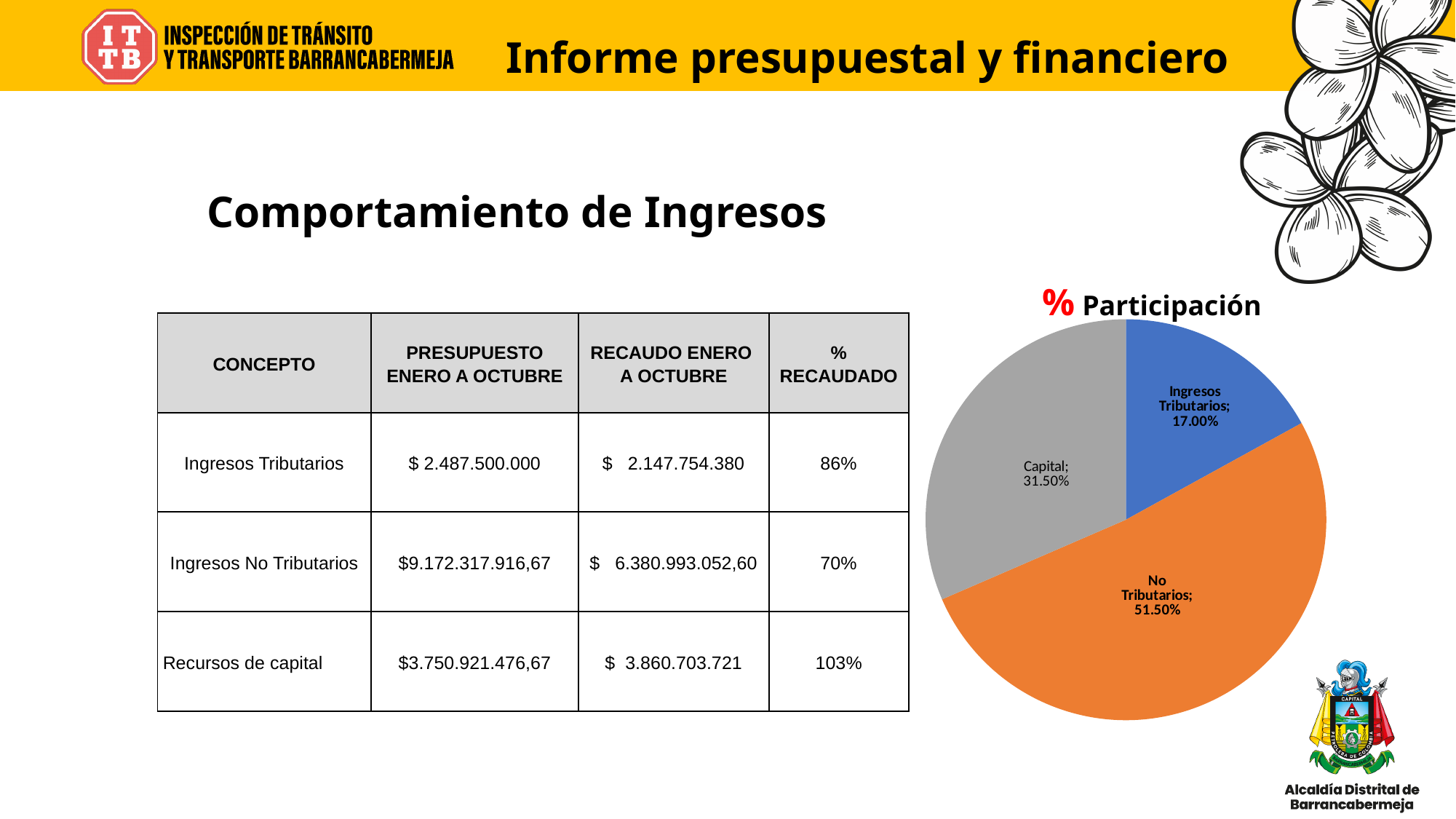
Which slice of the '% Participación' pie chart is the smallest? Ingresos Tributarios Which slice of the '% Participación' pie chart is the largest? No Tributarios In the '% Participación' pie chart, what is the difference between the Capital and Ingresos Tributarios slices? 14.50% How many slices does the '% Participación' pie chart have? 3 What colour is the No Tributarios slice in the '% Participación' pie chart? orange What is the title of the pie chart on the slide? % Participación In the '% Participación' pie chart, what is the value for Capital? 31.50% What type of chart is shown under the title '% Participación'? pie chart In the '% Participación' pie chart, what is the value for No Tributarios? 51.50% In the '% Participación' pie chart, which is larger: Capital or Ingresos Tributarios? Capital In the '% Participación' pie chart, what is the difference between the No Tributarios and Capital slices? 20.00% In the '% Participación' pie chart, what is the value for Ingresos Tributarios? 17.00%